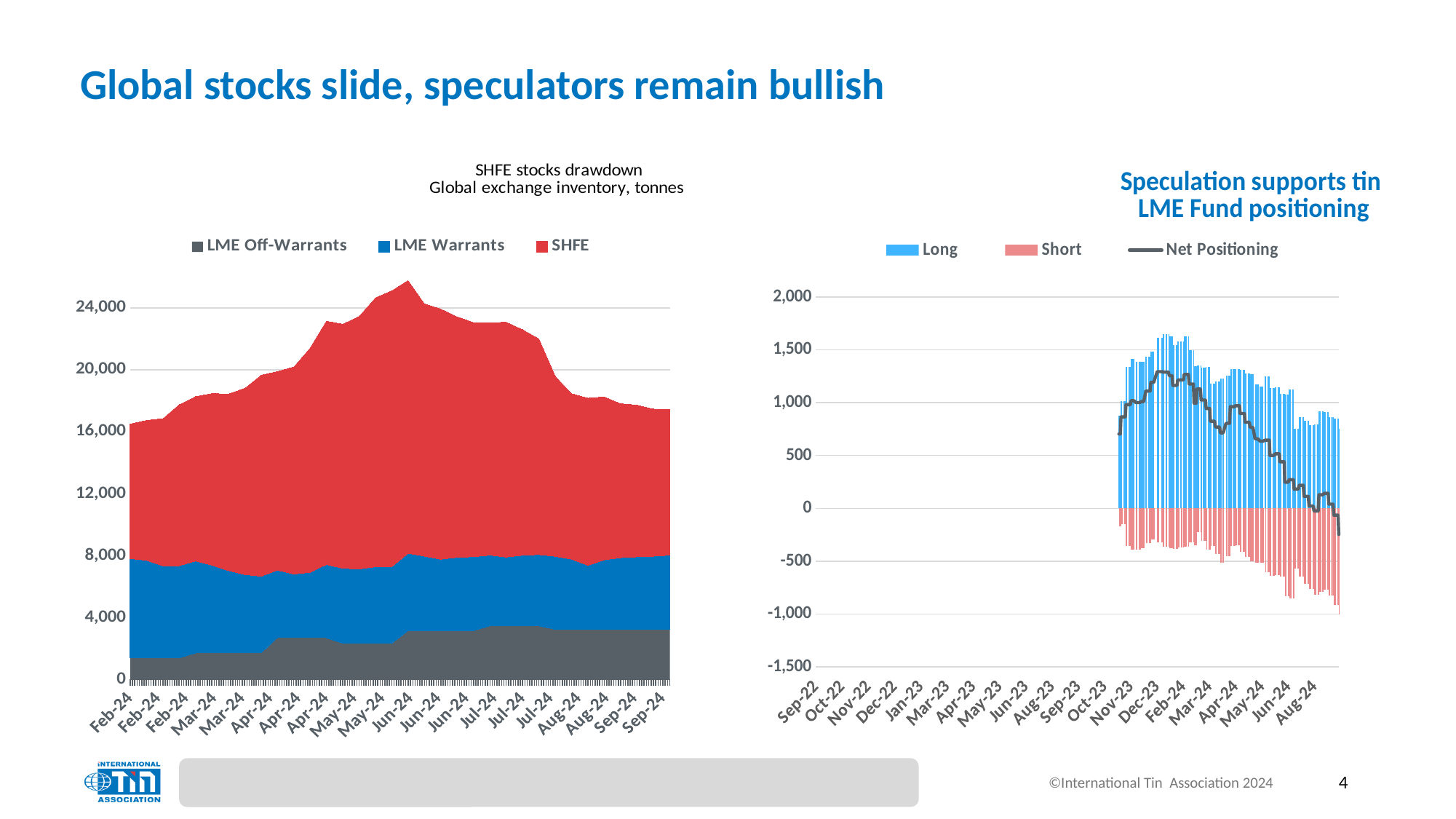
In the right chart (LME Fund positioning), does Net Positioning rise or fall between Feb-24 and Aug-24? fall In the right chart (LME Fund positioning), is the Net Positioning value at the end of the series in Aug-24 greater or less than 0? less In the left chart (Global exchange inventory), is the LME Off-Warrants value in Sep-24 greater or less than 4,000? less How many series does the legend of the left chart (Global exchange inventory) list? 3 In the right chart (LME Fund positioning), is the highest Long bar greater or less than 1,500? greater In the left chart (Global exchange inventory), does the total inventory rise or fall between Jun-24 and Sep-24? fall How many series does the legend of the right chart (LME Fund positioning) list? 3 In the left chart (Global exchange inventory), which series is shown in red? SHFE What kind of chart is the left chart titled "SHFE stocks drawdown"? Stacked area chart In the right chart (LME Fund positioning), which series is drawn as a dark line? Net Positioning